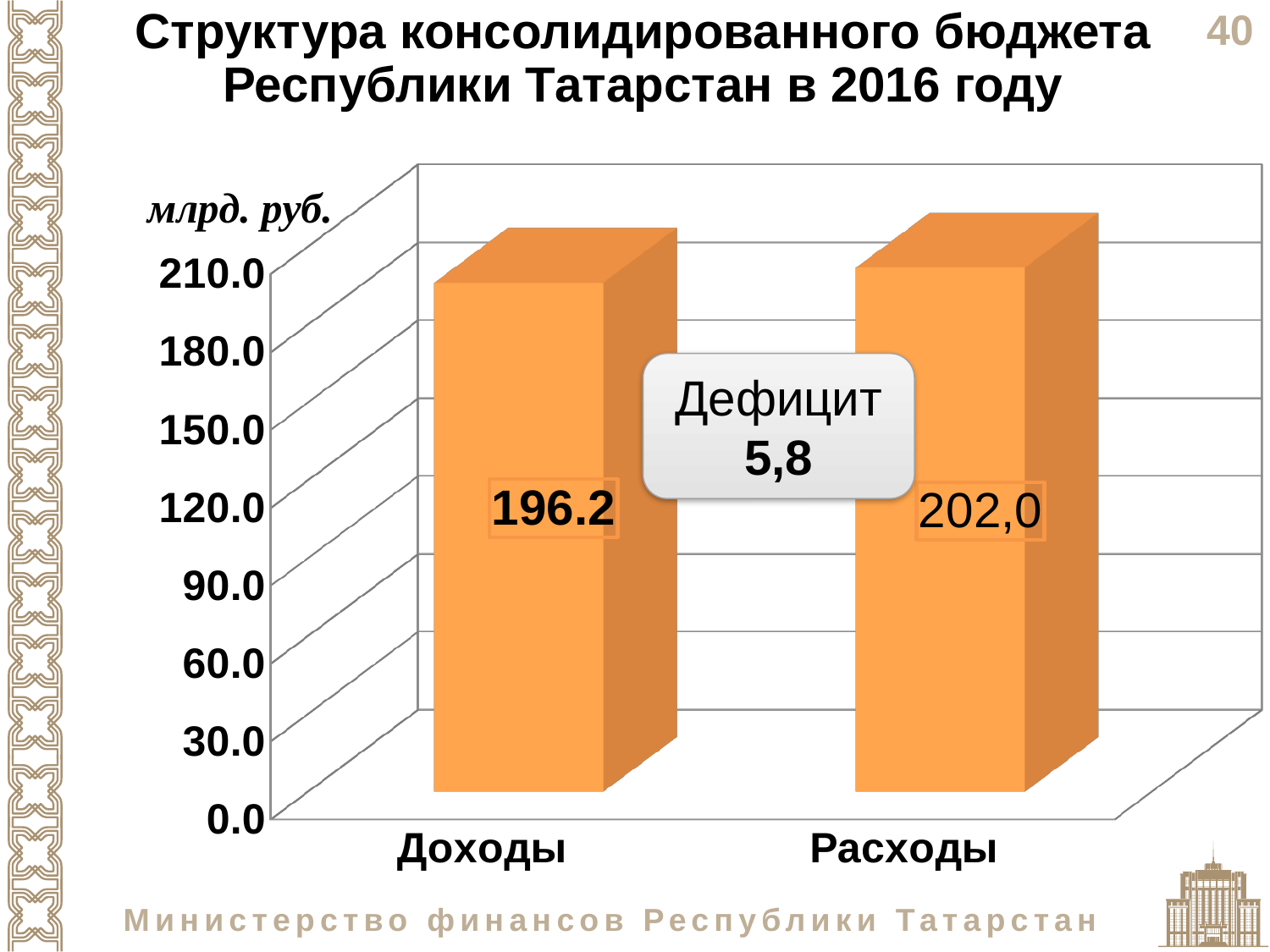
What is the difference between the values for Расходы and Доходы? 5.8 Which category has the highest value? Расходы Is the value for Расходы greater or less than 210.0? less What unit is shown on the chart's value axis? млрд. руб. Is the value for Доходы greater or less than 180.0? greater What deficit value is shown in the callout on the chart? 5,8 How many categories are shown on the chart? 2 Which category has the higher value, Доходы or Расходы? Расходы What kind of chart is shown on the slide? Bar chart What is the value for Расходы? 202,0 What is the value for Доходы? 196.2 Which category has the lowest value? Доходы